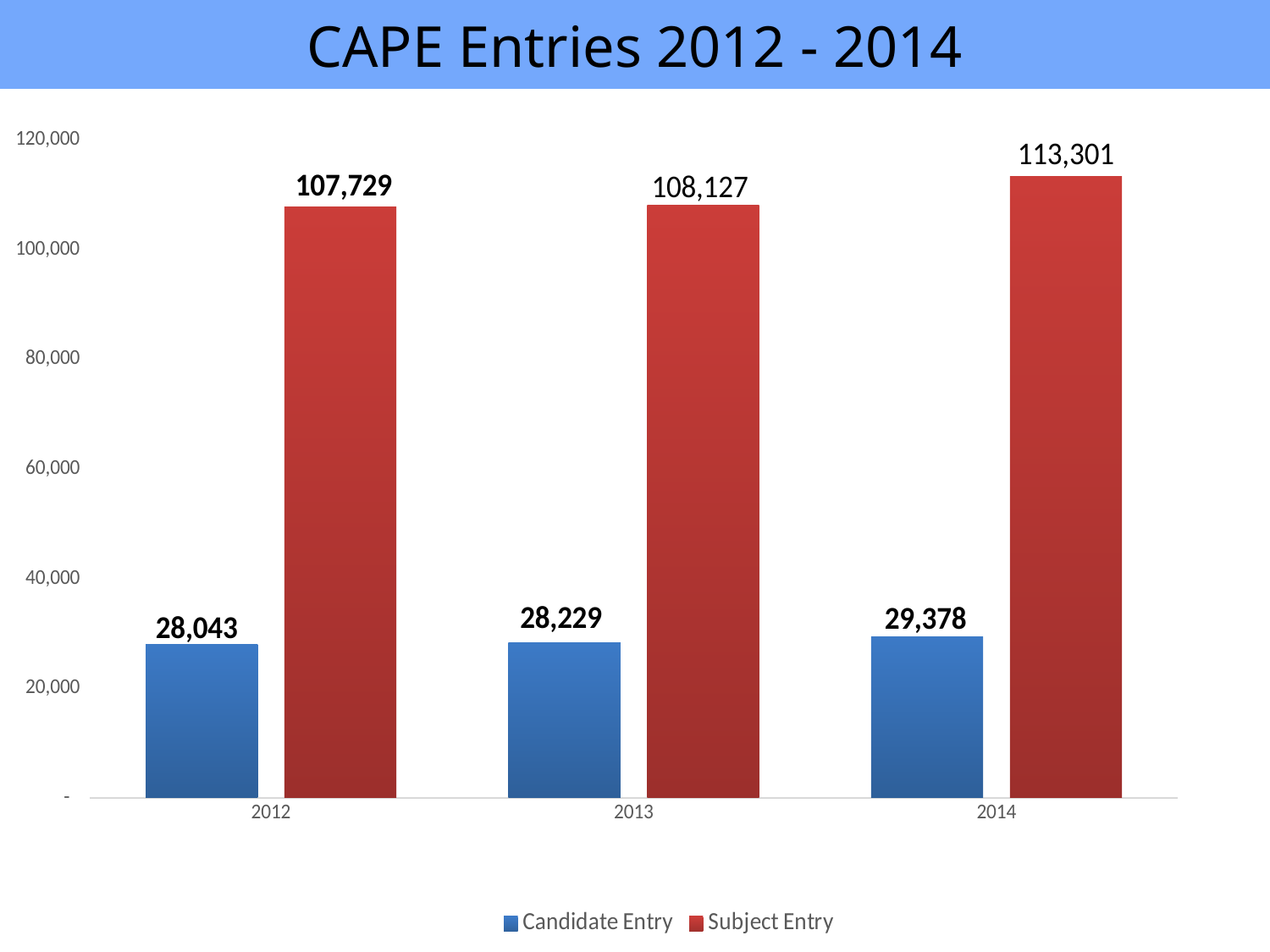
What is the Subject Entry value for 2013? 108,127 Is the Subject Entry value for 2012 greater or less than 100,000? greater How many years are shown on the x axis? 3 What is the Candidate Entry value for 2012? 28,043 What is the difference between the Subject Entry values for 2014 and 2012? 5,572 Which year has the lowest Candidate Entry value? 2012 Which year has the highest Subject Entry value? 2014 Which is larger in 2013: Candidate Entry or Subject Entry? Subject Entry How many series does the legend list? 2 What is the Subject Entry value for 2014? 113,301 What kind of chart is shown on the slide? Bar chart What is the difference between the Candidate Entry values for 2014 and 2013? 1,149